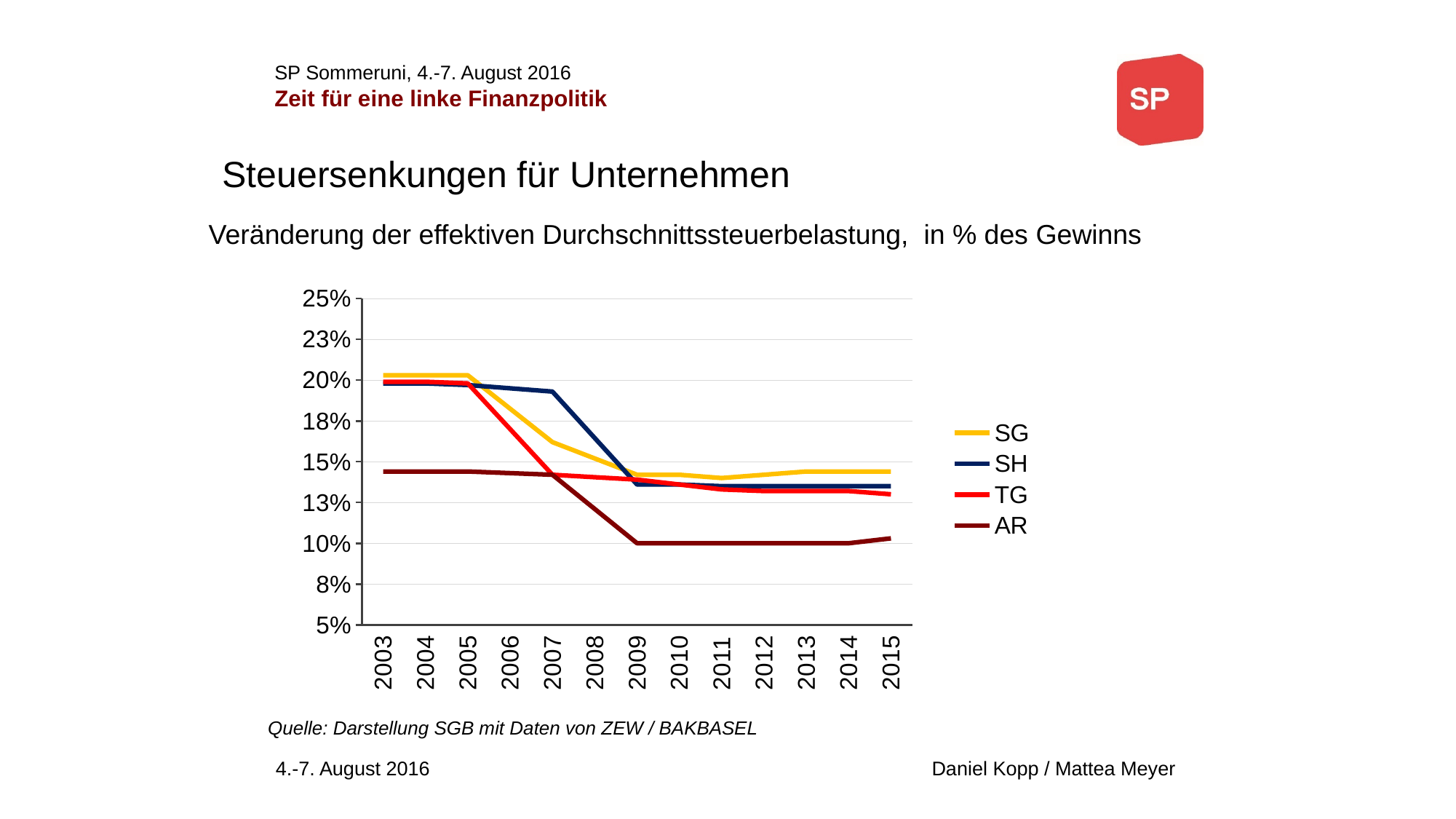
Which series has the highest value in 2015? SG Is the value for TG in 2015 greater or less than 15%? less Which is larger in 2007, the value for SG or the value for TG? SG Is the value for AR in 2009 greater or less than 13%? less How many years are shown on the x axis? 13 Which series has the lowest value in 2015? AR Is the value for SH in 2007 greater or less than 18%? greater Does the SG line rise or fall from 2003 to 2015? fall How many series does the legend list? 4 Which series has the lowest value in 2003? AR Which series is drawn in yellow? SG What kind of chart is shown on the slide? line chart